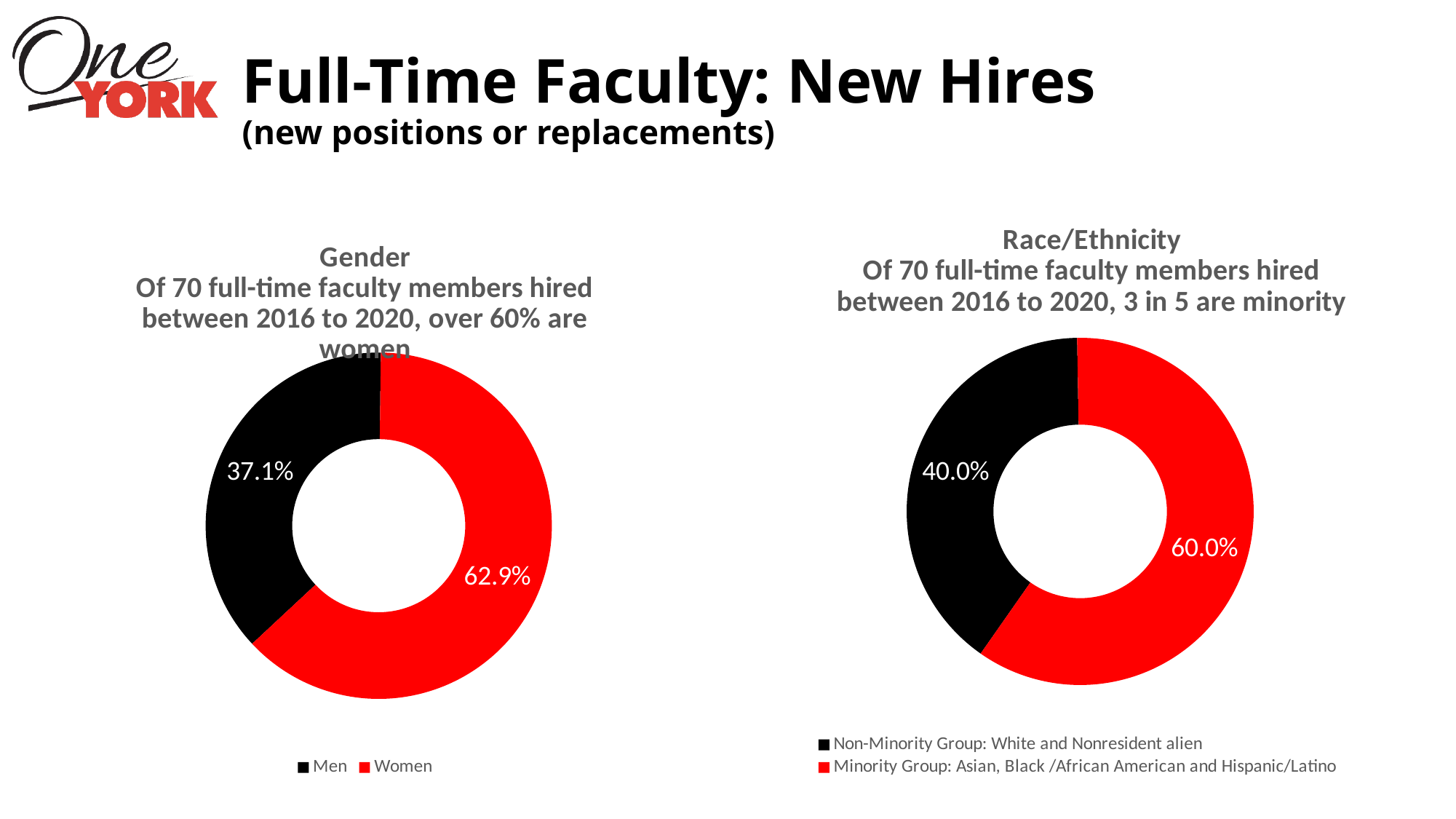
In the Gender chart, which colour represents Men? Black In the Gender chart, what percentage of new hires are men? 37.1% What type of chart is the Gender chart? Doughnut chart In the Gender chart, what percentage of new hires are women? 62.9% In the Race/Ethnicity chart, what share of new hires belongs to the Minority Group? 60.0% How many categories does the Race/Ethnicity chart show? 2 In the Race/Ethnicity chart, what share of new hires belongs to the Non-Minority Group? 40.0% In the Race/Ethnicity chart, what is the difference in percentage points between the Minority Group and the Non-Minority Group? 20.0 In the Race/Ethnicity chart, which group has the smaller share? Non-Minority Group: White and Nonresident alien In the Gender chart, which category has the larger share? Women Is the share of women in the Gender chart larger or smaller than the share of the Minority Group in the Race/Ethnicity chart? larger In the Gender chart, what is the difference in percentage points between women and men? 25.8